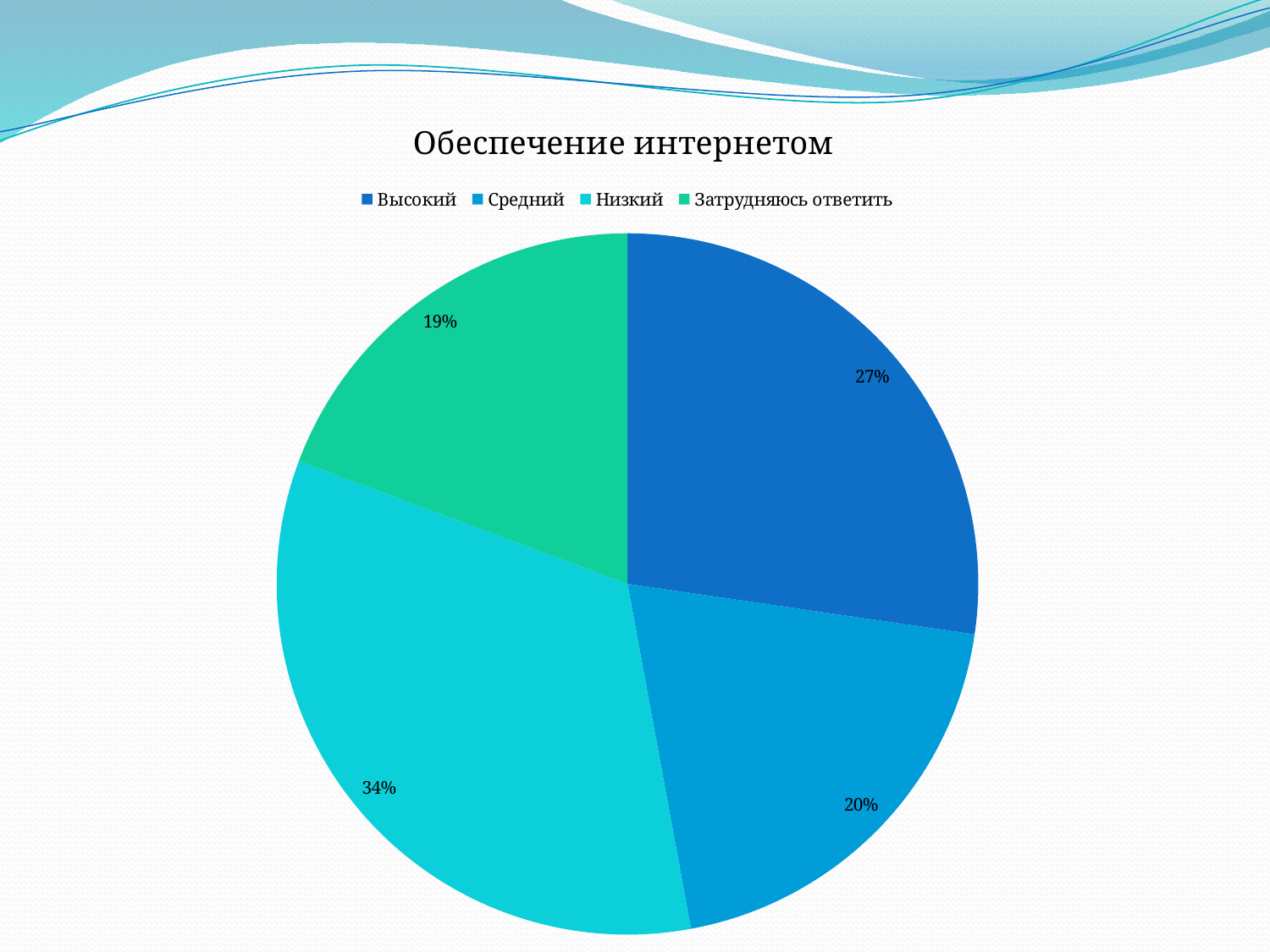
What is the difference in percentage points between Низкий and Высокий? 7 What percentage is shown for Затрудняюсь ответить? 19% What percentage is shown for Средний? 20% What percentage is shown for Низкий? 34% What is the title of the chart? Обеспечение интернетом How many slices does the pie chart have? 4 What percentage is shown for Высокий? 27% Which is larger, the share for Высокий or the share for Средний? Высокий Which category has the smallest share of the pie? Затрудняюсь ответить How many categories does the legend list? 4 Which category has the largest share of the pie? Низкий What type of chart is shown on the slide? pie chart